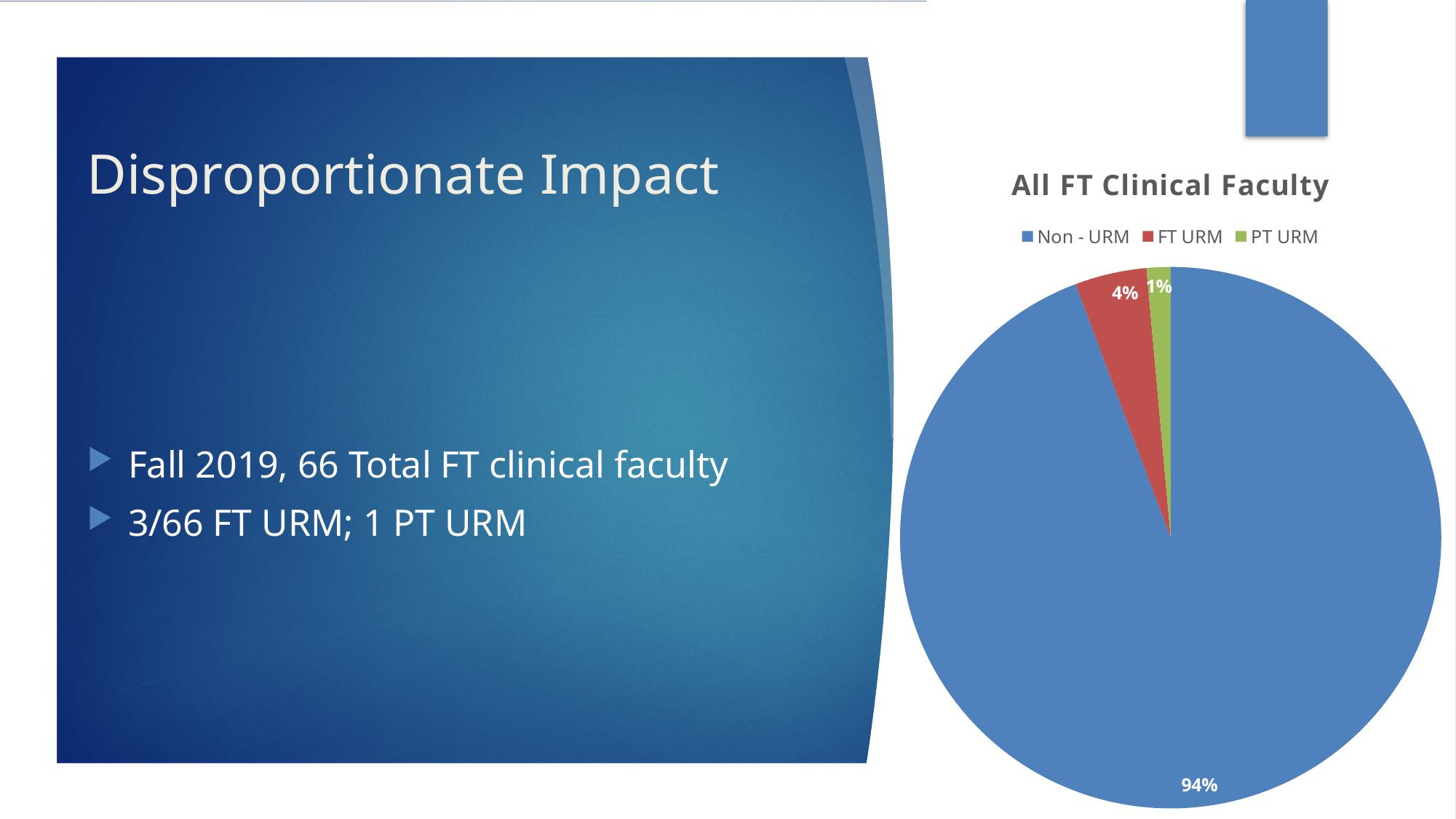
How many slices does the pie chart have? 3 What is the difference in percentage points between the Non - URM slice and the FT URM slice? 90 What colour is the FT URM slice? red Which slice is larger, FT URM or PT URM? FT URM What share of the pie does PT URM represent? 1% How many categories does the legend list? 3 What type of chart is shown on the slide? pie chart What is the title of the chart? All FT Clinical Faculty Which category has the smallest slice of the pie? PT URM What share of the pie does Non - URM represent? 94% Which category has the largest slice of the pie? Non - URM What share of the pie does FT URM represent? 4%